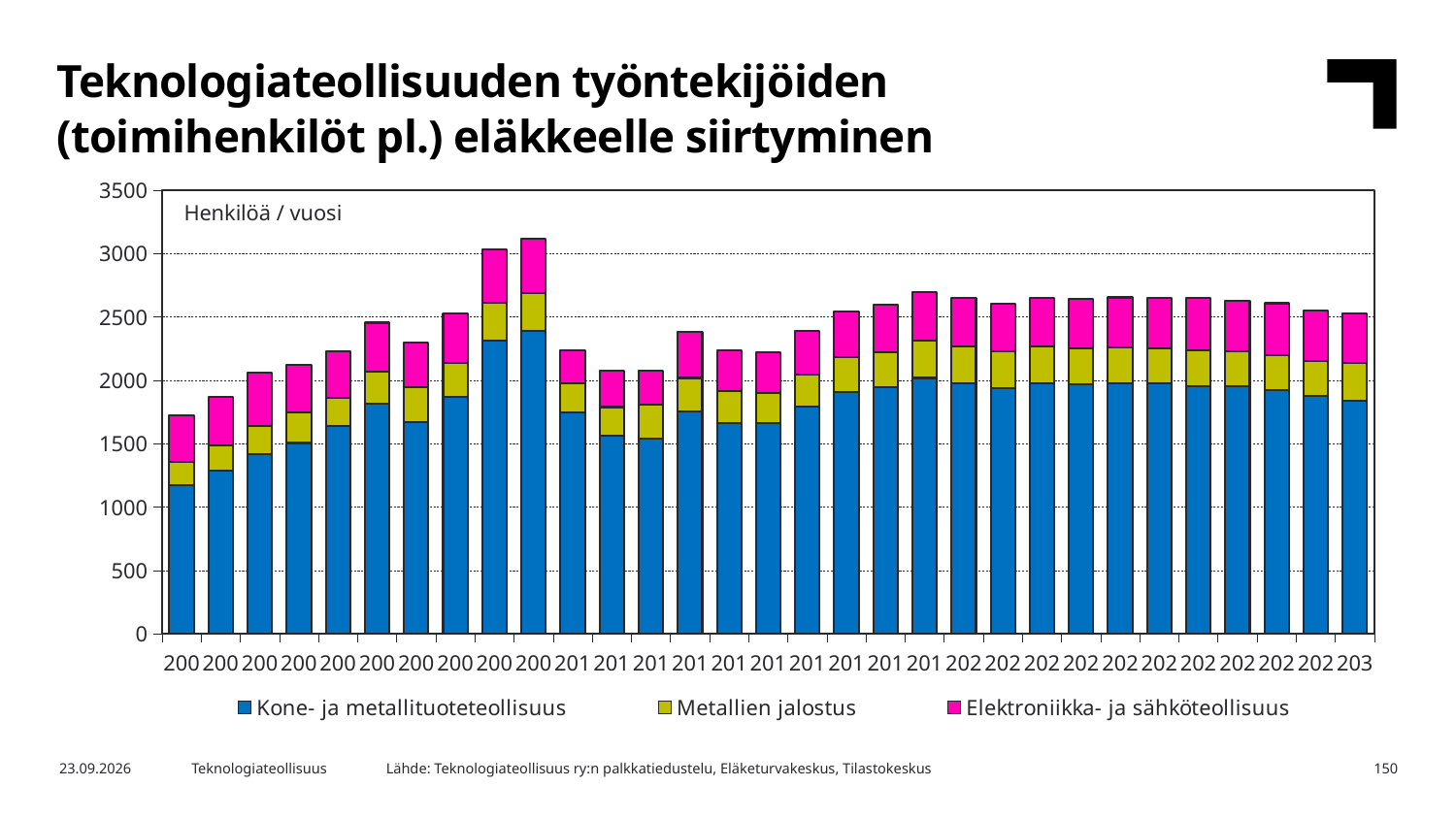
Is the total of the tallest bar greater or less than 3000? greater Is the total of the last (rightmost) bar greater or less than 2000? greater Which series forms the bottom segment of each stacked bar? Kone- ja metallituoteteollisuus Is the total of the first (leftmost) bar greater or less than 2000? less What kind of chart is shown on the slide? Stacked bar chart What unit label is printed inside the plot area at the top left? Henkilöä / vuosi Which series contributes the largest segment in every bar? Kone- ja metallituoteteollisuus Is the total of the first bar larger or smaller than the total of the last bar? smaller How many bars are plotted in the chart? 31 Do the bar totals generally rise or fall across the first ten bars from the left? rise How many series does the legend list? 3